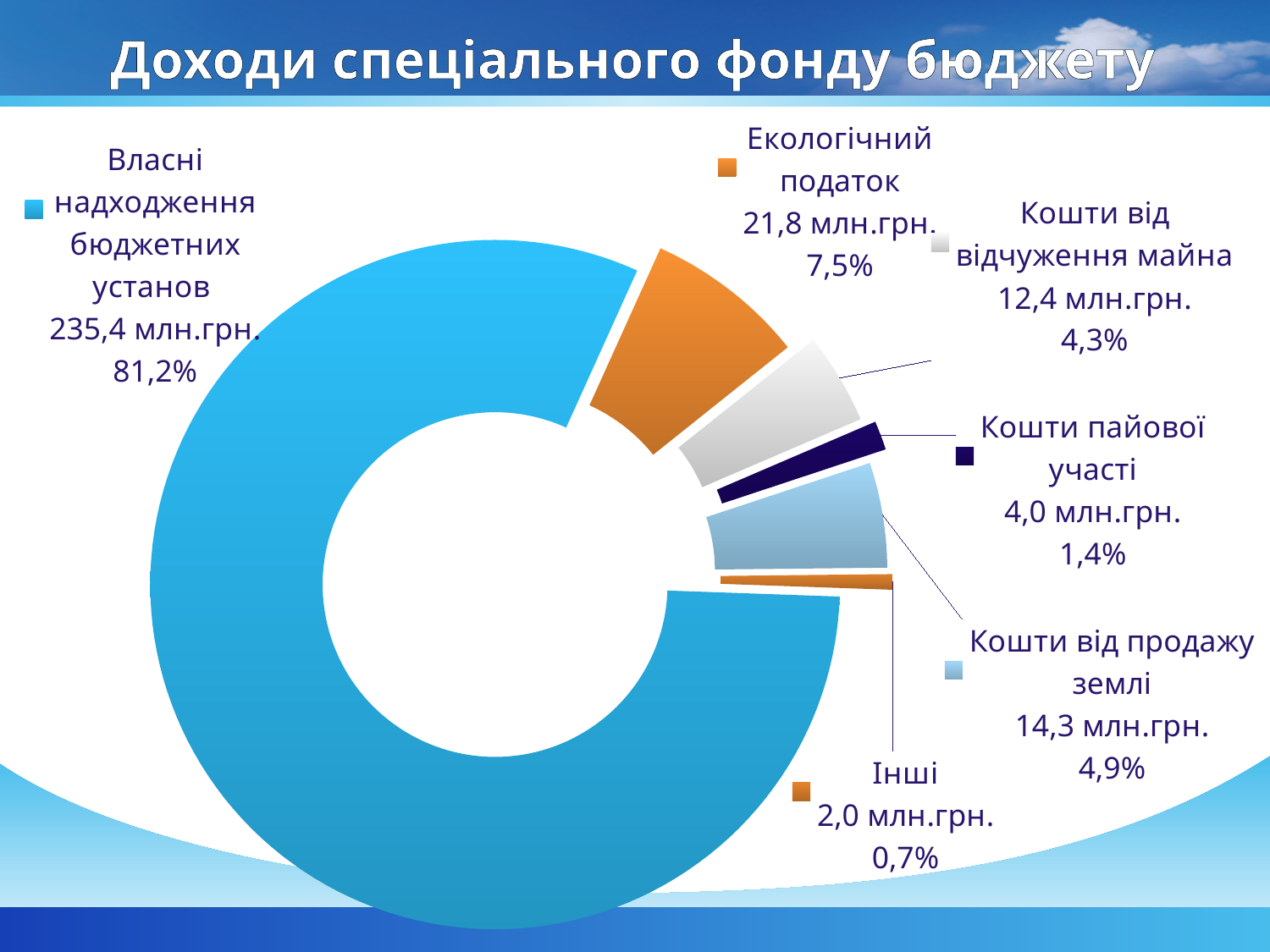
What is the title of the slide's chart? Доходи спеціального фонду бюджету Which category has the largest value? Власні надходження бюджетних установ What is the value for Кошти від продажу землі? 14,3 млн.грн. Which is larger, Кошти від продажу землі or Кошти від відчуження майна? Кошти від продажу землі What share of the total does Кошти пайової участі represent? 1,4% What is the value for Власні надходження бюджетних установ? 235,4 млн.грн. What share of the total does Кошти від відчуження майна represent? 4,3% Which category has the smallest value? Інші What is the value for Екологічний податок? 21,8 млн.грн. What kind of chart is shown on the slide? doughnut chart How many categories does the chart show? 6 What is the difference between Екологічний податок and Кошти від продажу землі? 7,5 млн.грн.